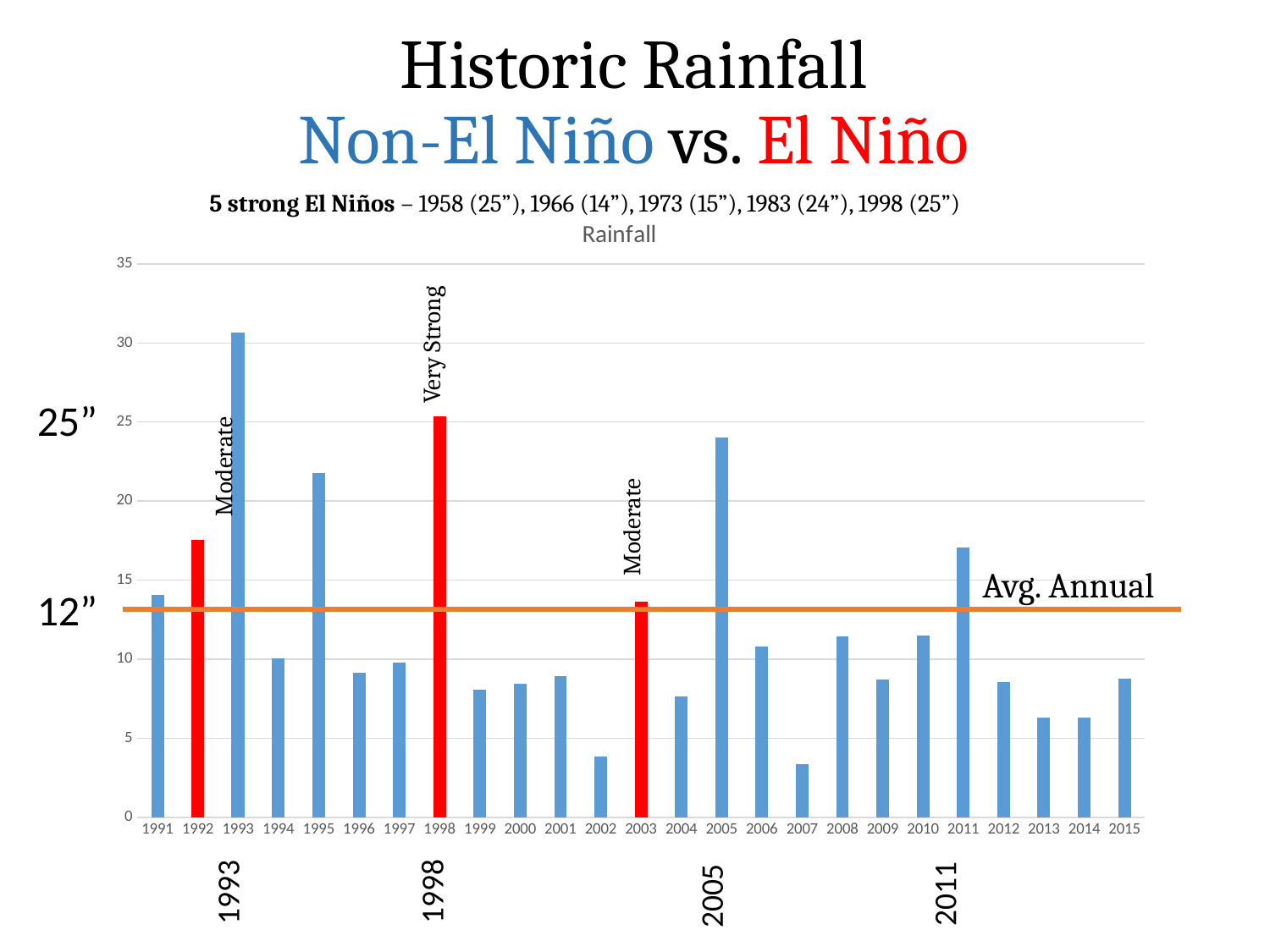
Is the rainfall value for 2005 greater or less than 20? greater Is the rainfall value for 2007 greater or less than 5? less What is the title printed above the chart's plot area? Rainfall What kind of chart is shown on the slide? bar chart How many years are plotted along the x axis of the chart? 25 Is the rainfall value for 2003 greater or less than 15? less Which year has the larger rainfall bar, 1993 or 1998? 1993 What label is written above the red bar for 1998? Very Strong Which year has the highest rainfall bar in the chart? 1993 Which year has the larger rainfall bar, 1992 or 2003? 1992